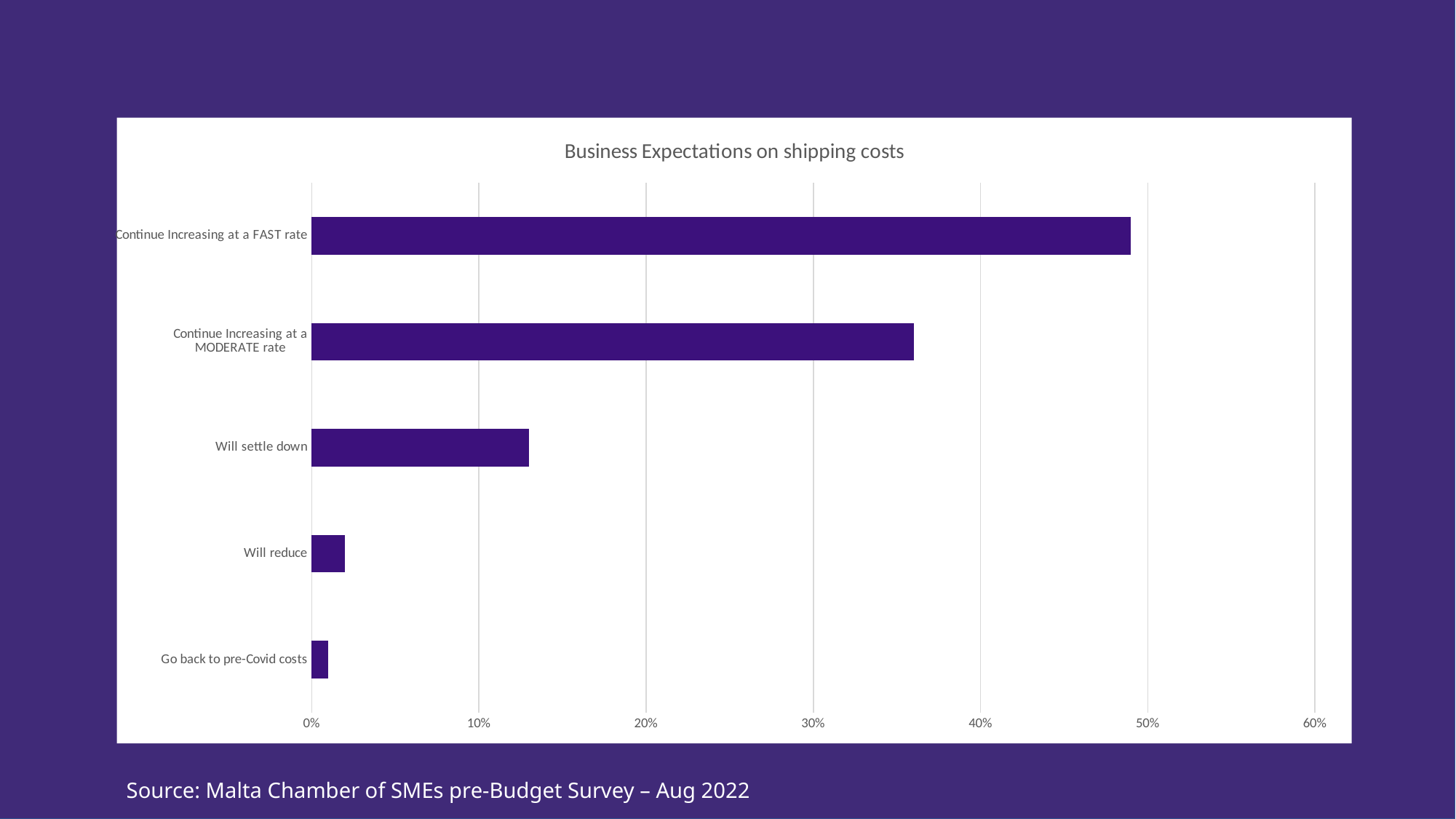
Which is larger, the value for 'Continue Increasing at a MODERATE rate' or the value for 'Continue Increasing at a FAST rate'? Continue Increasing at a FAST rate What is the title of the chart? Business Expectations on shipping costs What is the maximum value shown on the horizontal axis? 60% Is the value for 'Will settle down' greater or less than 20%? less What type of chart is shown on the slide? bar chart Is the value for 'Continue Increasing at a FAST rate' greater or less than 40%? greater Is the value for 'Will reduce' greater or less than 10%? less Which category has the highest value? Continue Increasing at a FAST rate Which is larger, the value for 'Will settle down' or the value for 'Will reduce'? Will settle down How many categories are shown in the chart? 5 Which category has the lowest value? Go back to pre-Covid costs